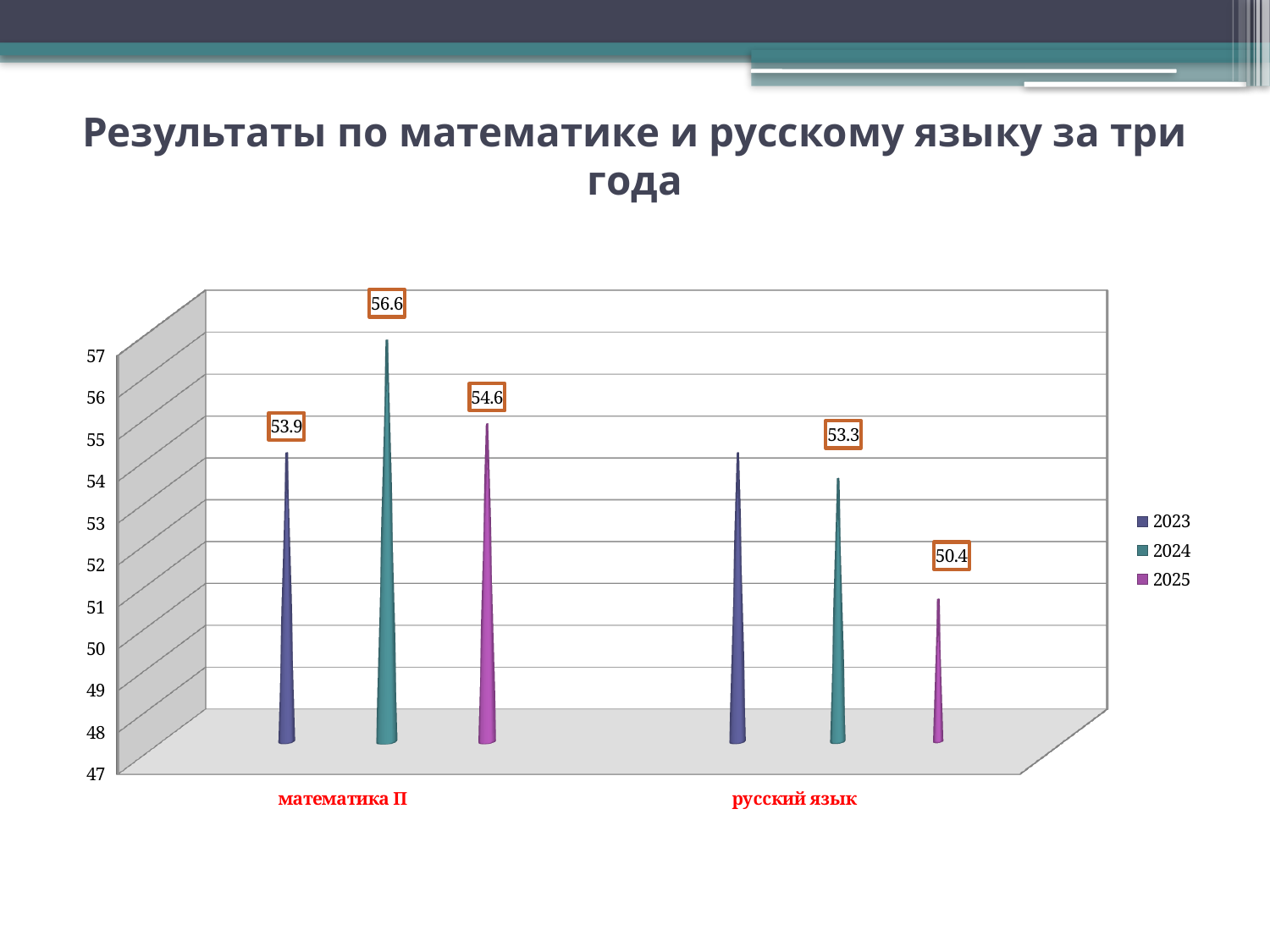
Is the value for 2023 in the русский язык category greater or less than 52? greater What is the value for 2024 in the математика П category? 56.6 Which is larger for 2025: математика П or русский язык? математика П What is the value for 2025 in the русский язык category? 50.4 How many series does the legend list? 3 What is the difference between the 2024 and 2025 values for русский язык? 2.9 What is the difference between the 2024 and 2025 values for математика П? 2.0 What is the value for 2024 in the русский язык category? 53.3 What kind of chart is shown on the slide? bar chart What is the value for 2023 in the математика П category? 53.9 Which year has the highest value for математика П? 2024 Which year has the lowest value for русский язык? 2025